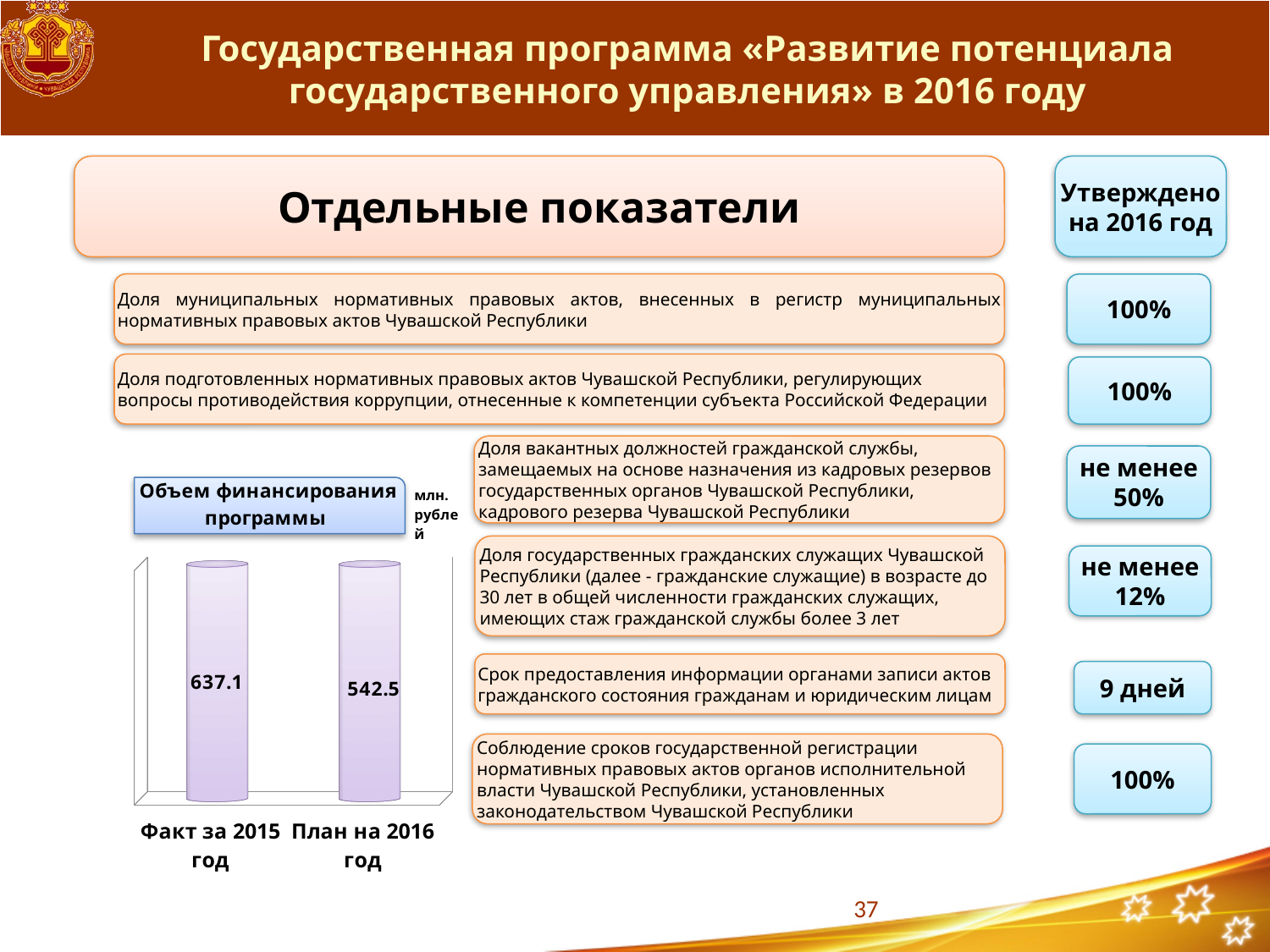
What is the title of the chart on the slide? Объем финансирования программы What is the difference between the values for "Факт за 2015 год" and "План на 2016 год" in the chart? 94.6 What is the value for "План на 2016 год" in the chart "Объем финансирования программы"? 542.5 What kind of chart is "Объем финансирования программы"? bar chart In what units are the values of the chart expressed, according to the label next to the title? млн. рублей Which is larger in the chart: the value for "Факт за 2015 год" or for "План на 2016 год"? Факт за 2015 год Which category has the highest value in the chart "Объем финансирования программы"? Факт за 2015 год Which category has the lowest value in the chart "Объем финансирования программы"? План на 2016 год Do the values in the chart rise or fall from "Факт за 2015 год" to "План на 2016 год"? fall How many categories are shown in the chart "Объем финансирования программы"? 2 What is the value for "Факт за 2015 год" in the chart "Объем финансирования программы"? 637.1